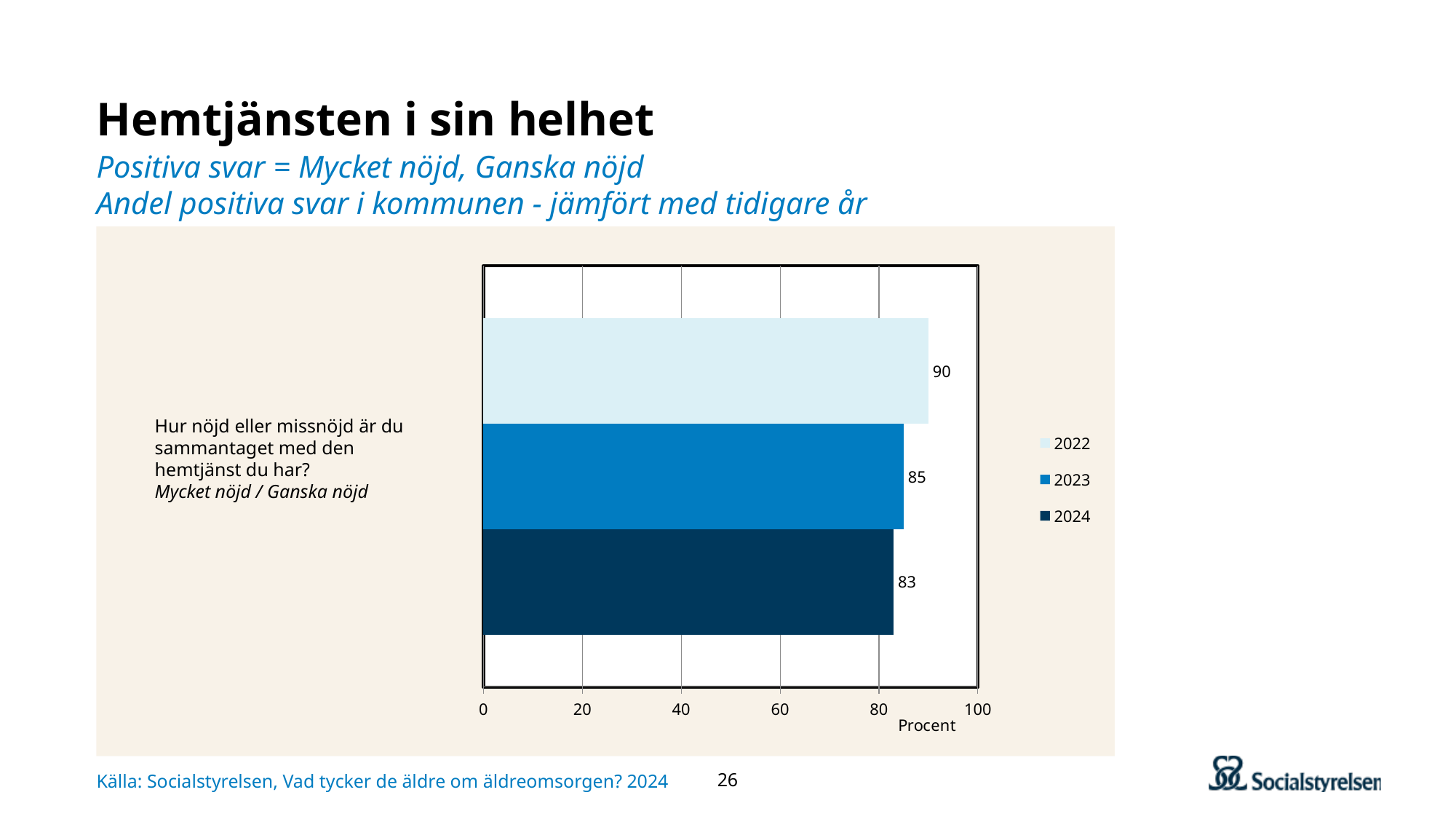
What kind of chart is shown on the slide? bar chart What is the difference between the values for 2023 and 2024? 2 Do the values rise or fall from 2022 to 2024? fall How many series does the legend list? 3 What is the difference between the values for 2022 and 2024? 7 What is the value for 2022? 90 What is the value for 2023? 85 Which year has the lowest share of positive answers? 2024 What is the value for 2024? 83 Which is larger, the value for 2022 or the value for 2023? 2022 Is the value for 2024 greater or less than 80? greater Which year has the highest share of positive answers? 2022